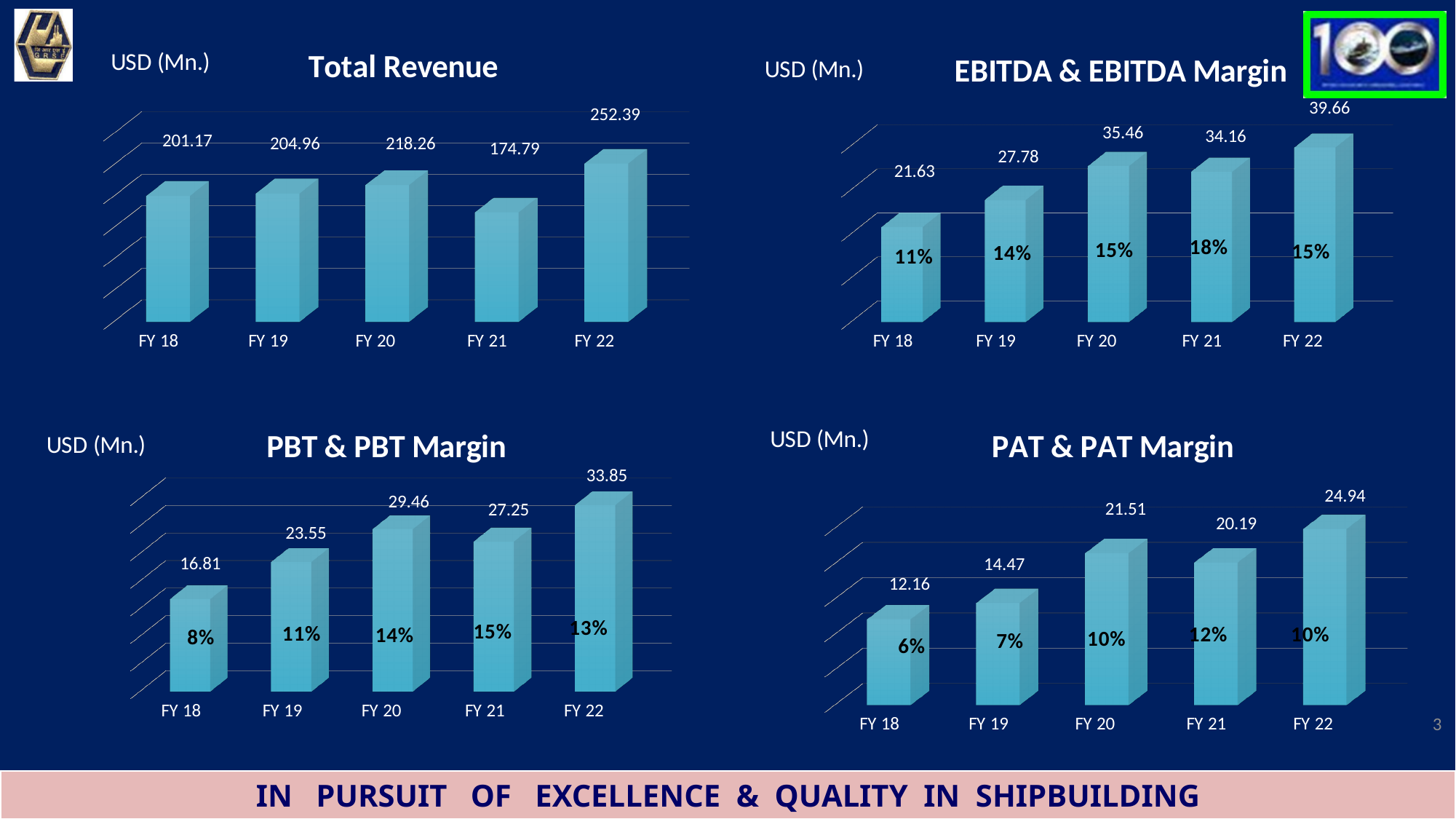
How many fiscal years are shown in the PAT & PAT Margin chart? 5 In the EBITDA & EBITDA Margin chart, which fiscal year has the highest EBITDA value? FY 22 In the EBITDA & EBITDA Margin chart, what is the EBITDA margin for FY 21? 18% In the Total Revenue chart, what is the value for FY 22? 252.39 In the Total Revenue chart, which fiscal year has the lowest value? FY 21 In the PBT & PBT Margin chart, what is the PBT value for FY 19? 23.55 In the PAT & PAT Margin chart, what is the PAT margin for FY 18? 6% In the Total Revenue chart, what is the difference between FY 22 and FY 21? 77.60 What type of chart is the Total Revenue chart? Bar chart In the PAT & PAT Margin chart, what is the difference between the PAT values for FY 22 and FY 18? 12.78 In the EBITDA & EBITDA Margin chart, what is the EBITDA value for FY 20? 35.46 In the PBT & PBT Margin chart, which is larger, the PBT value for FY 20 or FY 21? FY 20